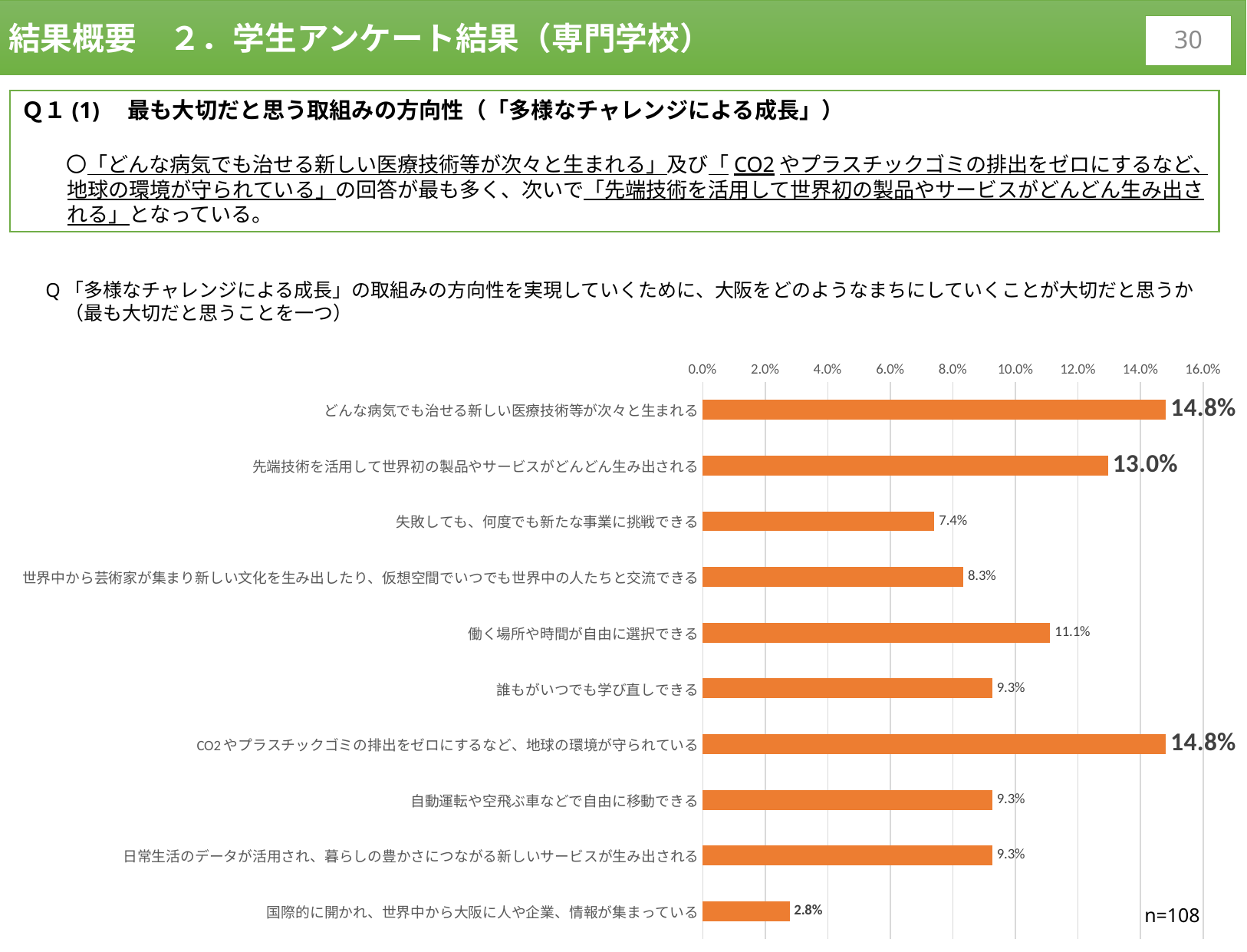
What kind of chart is shown on the slide? Bar chart What is the value for 「働く場所や時間が自由に選択できる」? 11.1% What is the value for 「失敗しても、何度でも新たな事業に挑戦できる」? 7.4% Which is larger: the value for 「働く場所や時間が自由に選択できる」 or the value for 「世界中から芸術家が集まり新しい文化を生み出したり、仮想空間でいつでも世界中の人たちと交流できる」? 働く場所や時間が自由に選択できる What is the value for 「どんな病気でも治せる新しい医療技術等が次々と生まれる」? 14.8% What sample size (n) is shown next to the chart? n=108 What is the difference between the value for 「どんな病気でも治せる新しい医療技術等が次々と生まれる」 and the value for 「先端技術を活用して世界初の製品やサービスがどんどん生み出される」? 1.8 percentage points How many categories (response options) are plotted in the chart? 10 Is the value for 「誰もがいつでも学び直しできる」 greater or less than 10.0%? less What is the value for 「国際的に開かれ、世界中から大阪に人や企業、情報が集まっている」? 2.8% Which category has the lowest value in the chart? 国際的に開かれ、世界中から大阪に人や企業、情報が集まっている What is the value for 「先端技術を活用して世界初の製品やサービスがどんどん生み出される」? 13.0%